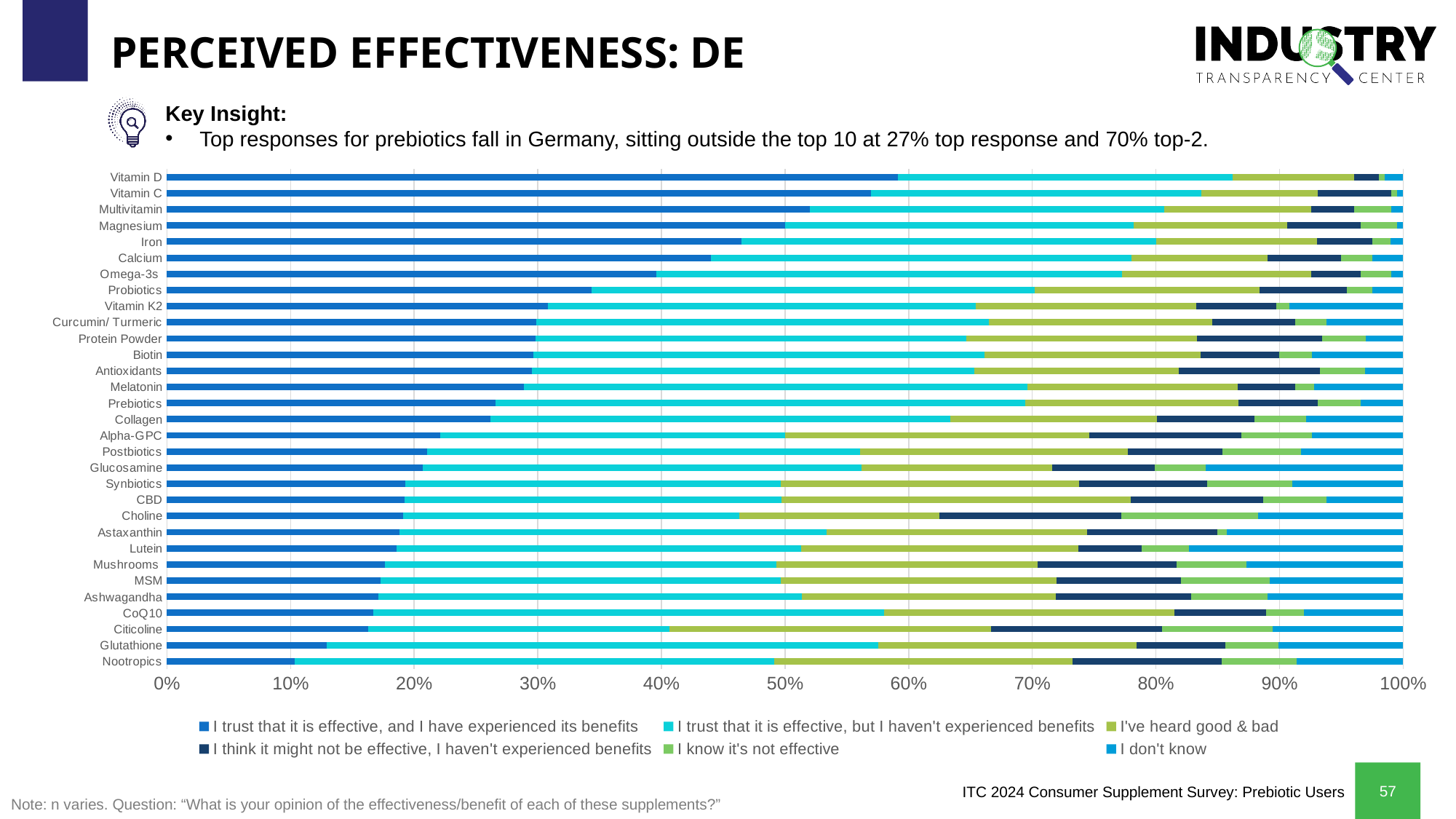
What kind of chart is shown on the slide? Stacked bar chart What is the title of the slide? PERCEIVED EFFECTIVENESS: DE According to the key insight, what is the top response percentage for prebiotics in Germany? 27% Is the 'I trust that it is effective, and I have experienced its benefits' value for Vitamin D greater or less than 50%? greater What is the total of the stacked bar for Vitamin D? 100% How many series does the legend list? 6 Which supplement has the smallest share for 'I trust that it is effective, and I have experienced its benefits'? Nootropics Which supplement has the largest share for 'I trust that it is effective, and I have experienced its benefits'? Vitamin D Is the 'I trust that it is effective, and I have experienced its benefits' value for Iron greater or less than 50%? less Which has a larger 'I trust that it is effective, and I have experienced its benefits' share, Vitamin C or Glutathione? Vitamin C Is the 'I trust that it is effective, and I have experienced its benefits' value for Probiotics greater or less than 40%? less How many supplement categories are plotted on the chart? 31